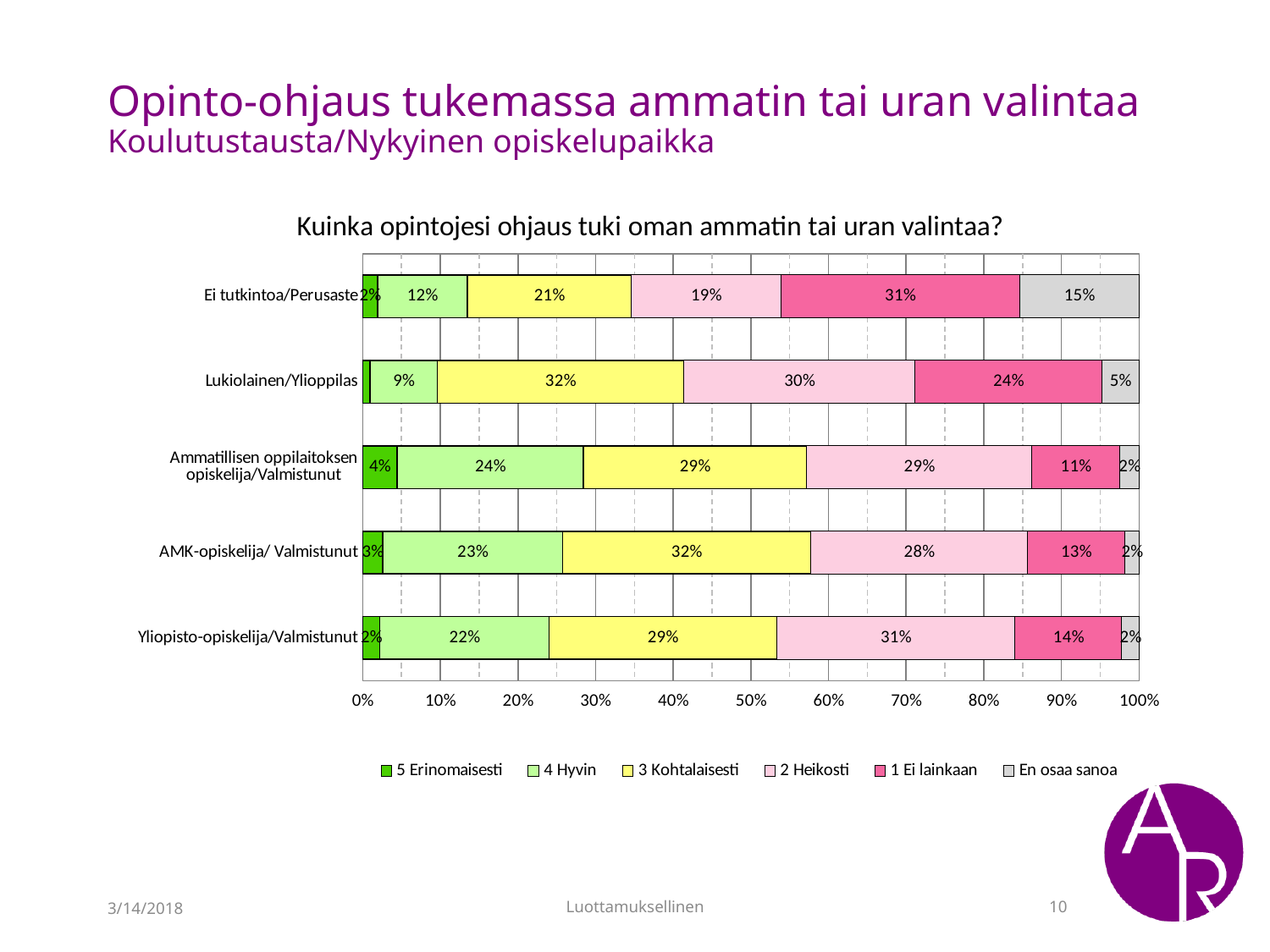
What is the value of '4 Hyvin' for Ammatillisen oppilaitoksen opiskelija/Valmistunut? 24% How many series does the legend list? 6 What is the title of the chart? Kuinka opintojesi ohjaus tuki oman ammatin tai uran valintaa? How many categories (education backgrounds) are shown on the chart? 5 Which is larger: the '1 Ei lainkaan' value for Lukiolainen/Ylioppilas or for AMK-opiskelija/ Valmistunut? Lukiolainen/Ylioppilas What is the value of '1 Ei lainkaan' for Ei tutkintoa/Perusaste? 31% Which category has the highest value for '1 Ei lainkaan'? Ei tutkintoa/Perusaste What is the difference between the '2 Heikosti' values for Yliopisto-opiskelija/Valmistunut and Ei tutkintoa/Perusaste? 12% What is the value of 'En osaa sanoa' for Ei tutkintoa/Perusaste? 15% Which category has the lowest value for '4 Hyvin'? Lukiolainen/Ylioppilas What kind of chart is shown on the slide? Stacked bar chart What is the value of '3 Kohtalaisesti' for Lukiolainen/Ylioppilas? 32%